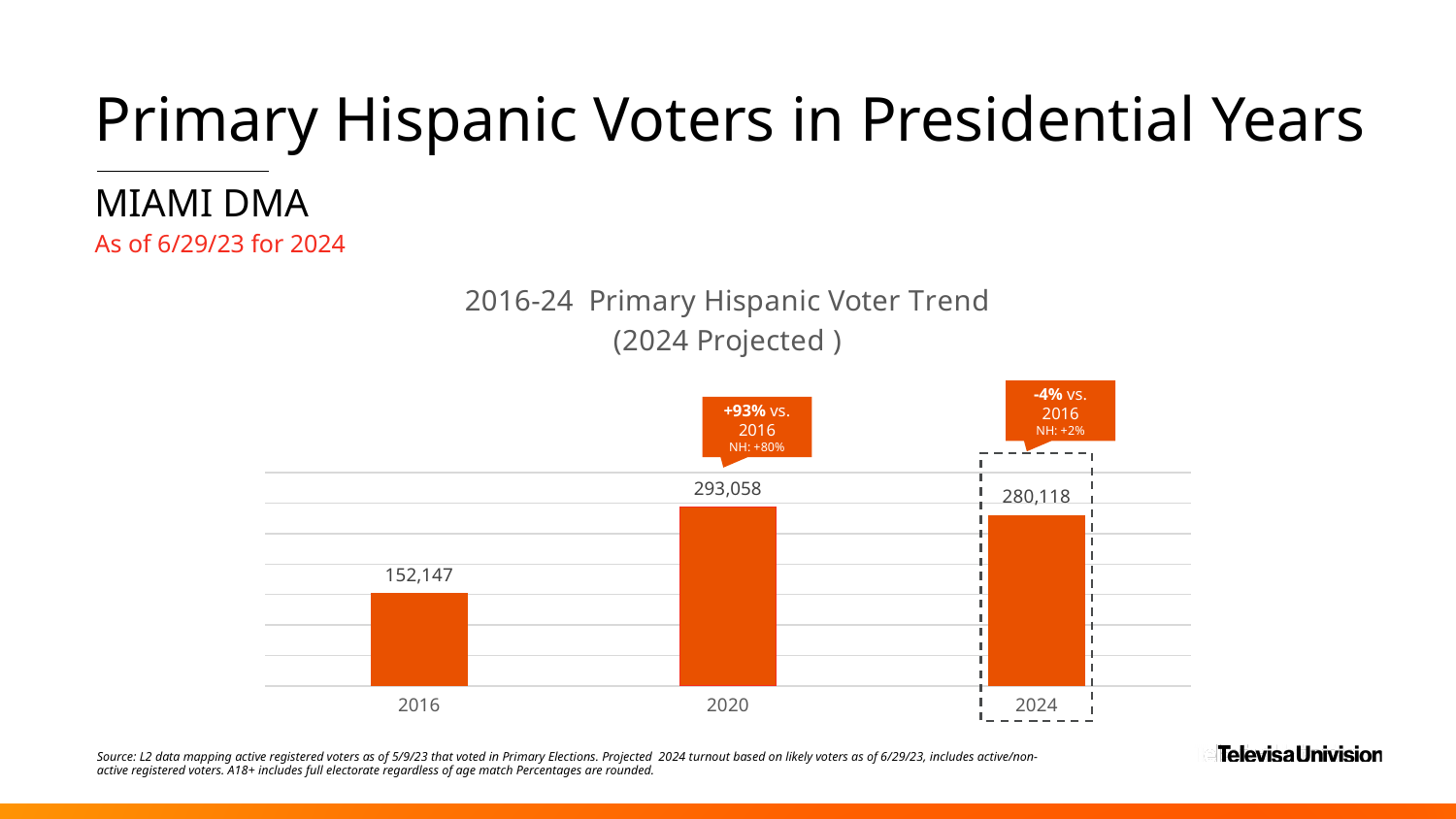
What is the difference between the 2020 and 2024 values? 12,940 What is the value for 2020? 293,058 How many years are shown on the chart? 3 What is the projected value for 2024? 280,118 Which year has the lowest value? 2016 Which is larger, the value for 2016 or the value for 2024? 2024 What kind of chart is this? Bar chart What percentage change vs. 2016 is shown in the callout above the 2020 bar? +93% What is the difference between the 2020 and 2016 values? 140,911 Which year has the highest value? 2020 What is the value for 2016? 152,147 What is the title of the chart? 2016-24 Primary Hispanic Voter Trend (2024 Projected )